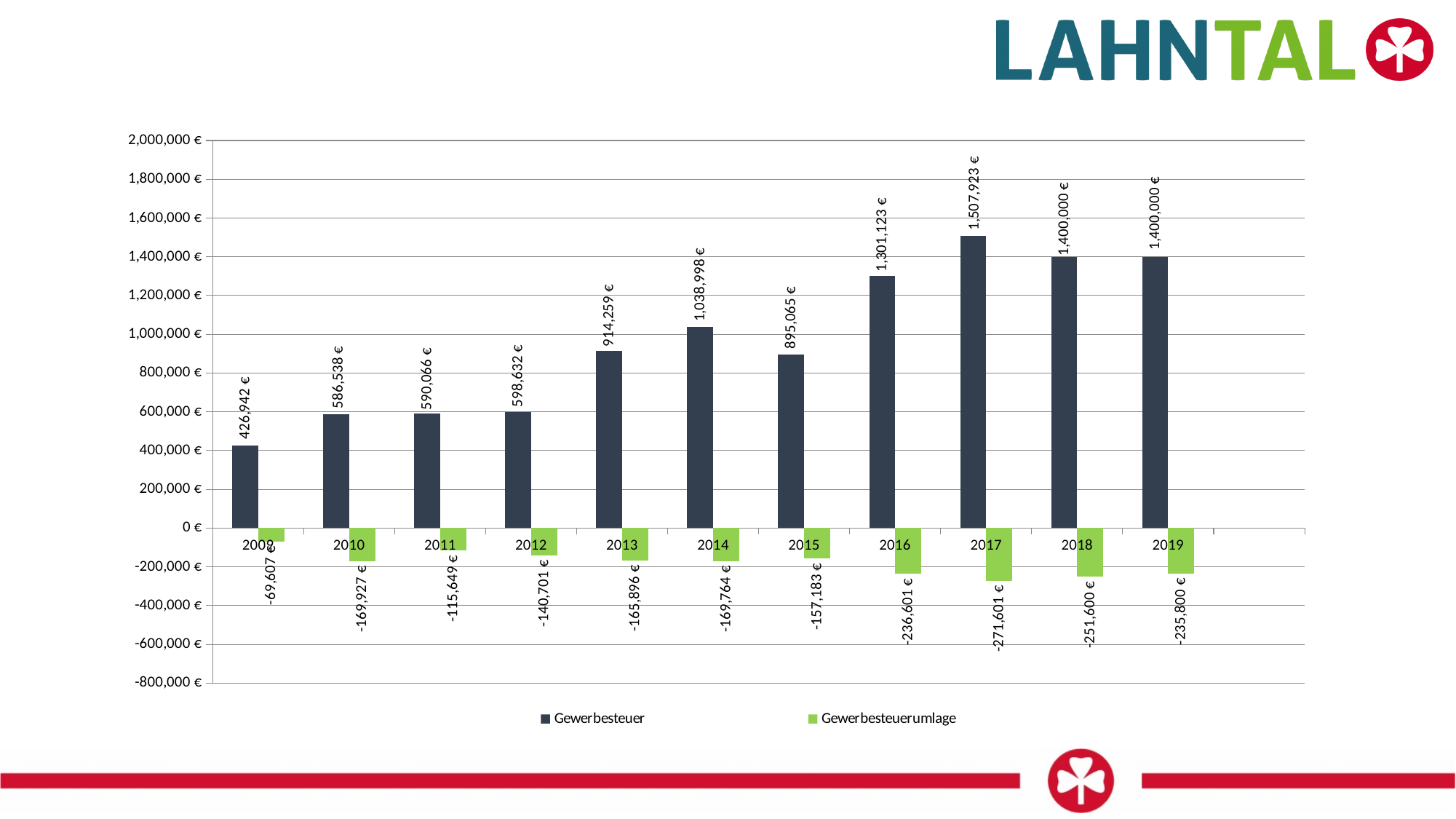
What is the Gewerbesteuer value for 2009? 426,942 € What kind of chart is shown on the slide? Bar chart Which series is shown in green in the legend? Gewerbesteuerumlage How many years are shown on the x axis? 11 Which year has the highest Gewerbesteuer value? 2017 What is the difference between the Gewerbesteuer values for 2017 and 2016? 206,800 € How many series does the legend list? 2 Which is larger, the Gewerbesteuer value for 2013 or for 2015? 2013 What is the Gewerbesteuer value for 2014? 1,038,998 € What is the Gewerbesteuerumlage value for 2017? -271,601 € Do the Gewerbesteuer values generally rise or fall from 2009 to 2017? Rise Which year has the lowest Gewerbesteuer value? 2009